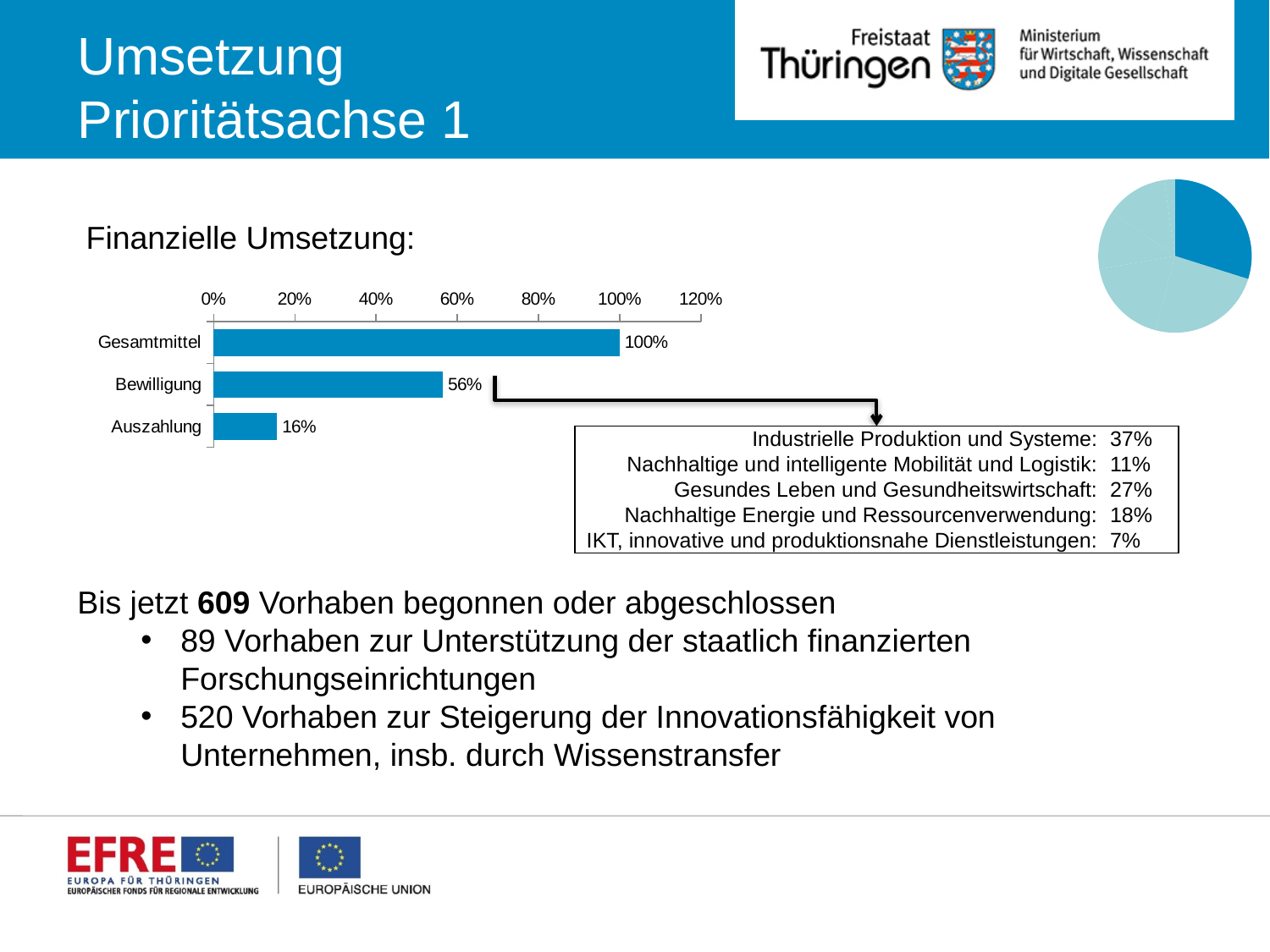
What is the value for Gesamtmittel in the bar chart? 100% What is the highest tick value shown on the x axis of the bar chart? 120% What is the value for Bewilligung in the bar chart? 56% What is the value for Auszahlung in the bar chart? 16% Is the value for Bewilligung in the bar chart greater or less than 60%? less What is the difference between the values for Gesamtmittel and Bewilligung in the bar chart? 44% Which is larger in the bar chart, Bewilligung or Auszahlung? Bewilligung Which category has the lowest value in the bar chart? Auszahlung What kind of chart is used to show the financial implementation (Finanzielle Umsetzung)? bar chart What is the difference between the values for Bewilligung and Auszahlung in the bar chart? 40% Which category has the highest value in the bar chart? Gesamtmittel How many categories are shown in the bar chart? 3